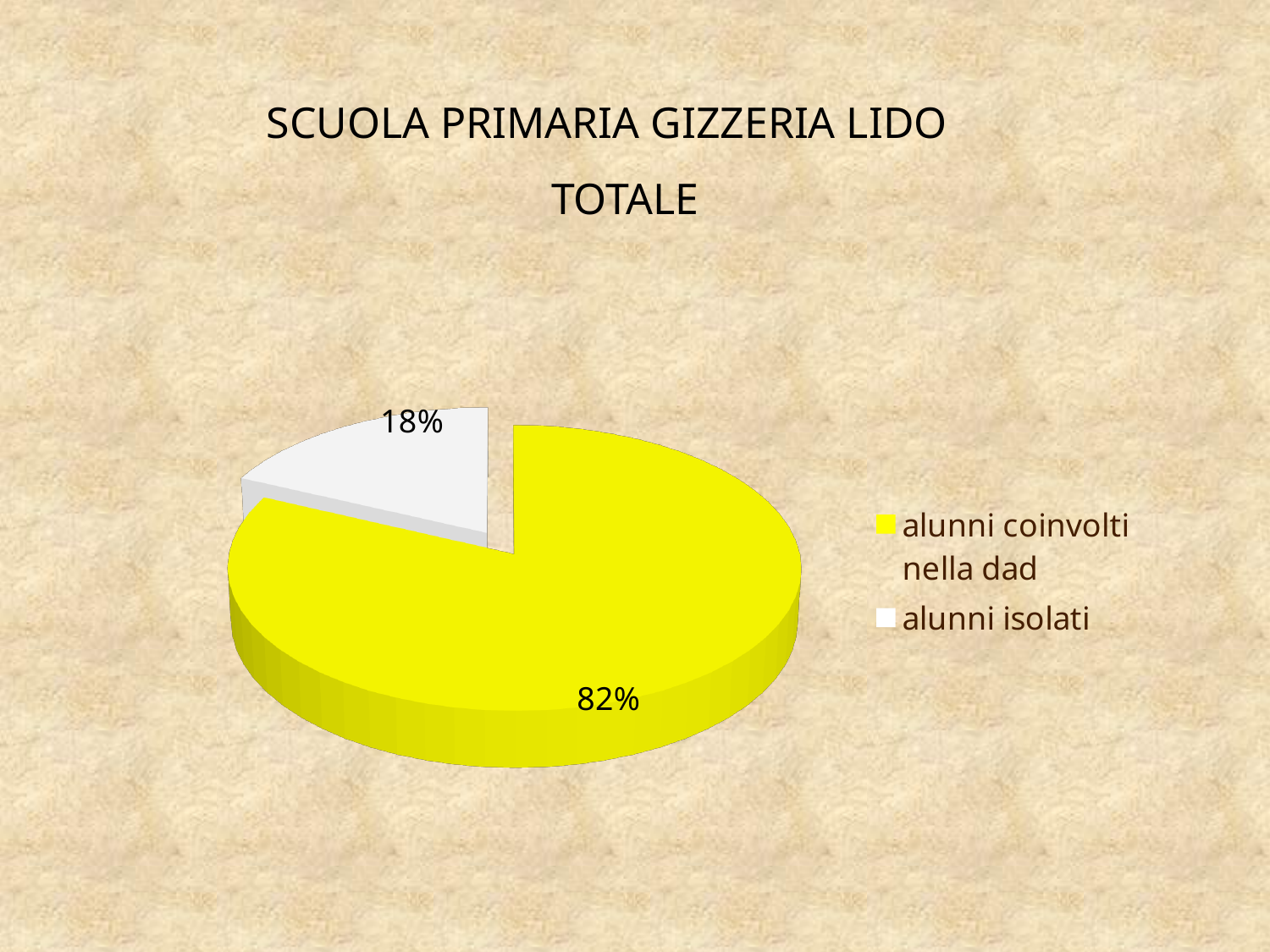
What colour is the slice for 'alunni coinvolti nella dad'? yellow What percentage of the pie is labelled for 'alunni isolati'? 18% What kind of chart is shown on the slide? pie chart What is the title shown above the chart? SCUOLA PRIMARIA GIZZERIA LIDO TOTALE Which category has the smallest share of the pie? alunni isolati How many entries does the legend list? 2 How many slices does the pie chart have? 2 What is the difference in percentage points between 'alunni coinvolti nella dad' and 'alunni isolati'? 64 What percentage of the pie is labelled for 'alunni coinvolti nella dad'? 82% What share of the pie does the 'alunni isolati' slice represent? 18% Which is larger: the share for 'alunni coinvolti nella dad' or for 'alunni isolati'? alunni coinvolti nella dad Which category has the largest share of the pie? alunni coinvolti nella dad